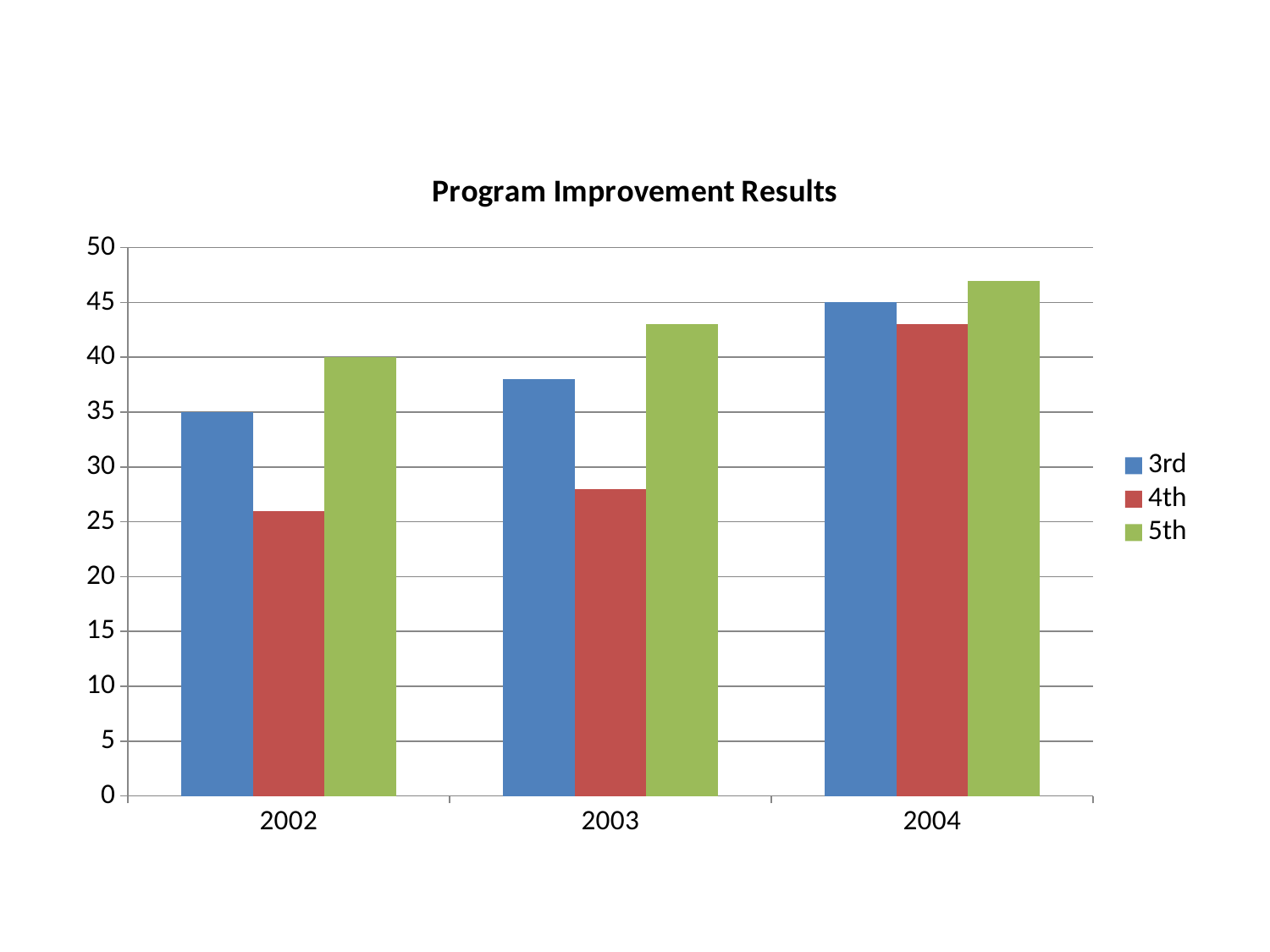
Which series has the lowest value in 2002? 4th What is the value for 3rd in 2002? 35 What kind of chart is shown on the slide? bar chart What is the value for 3rd in 2004? 45 How many series does the legend list? 3 Is the value for 4th in 2002 greater or less than 30? less How many year categories are shown on the x axis? 3 Do the values for the 3rd series rise or fall from 2002 to 2004? rise What is the difference between the 5th and 3rd values in 2002? 5 What is the title of the chart? Program Improvement Results What is the value for 5th in 2002? 40 Is the value for 5th in 2004 greater or less than 45? greater